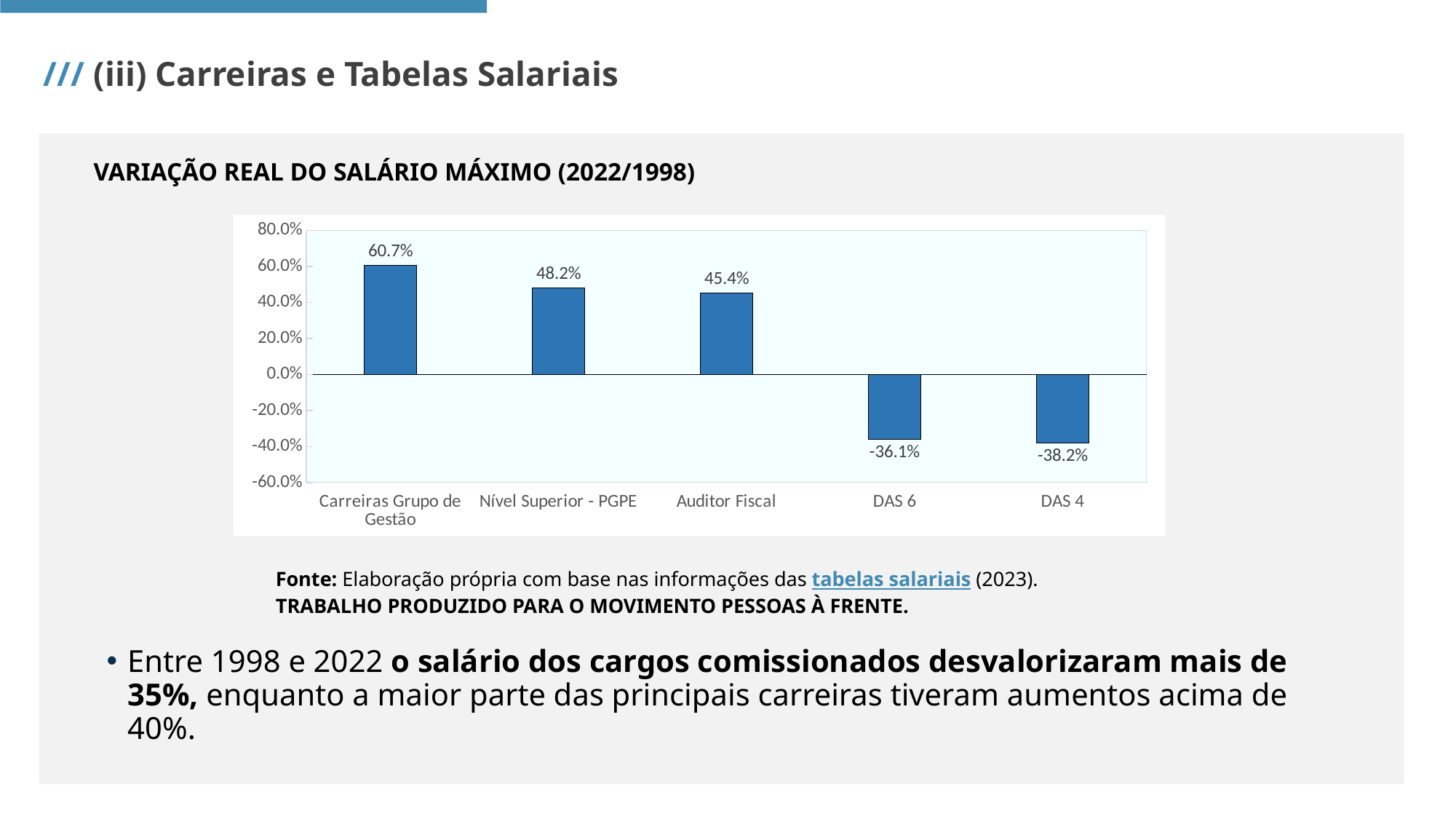
What kind of chart is shown on the slide? Bar chart What is the value for Auditor Fiscal? 45.4% What is the title of the chart? VARIAÇÃO REAL DO SALÁRIO MÁXIMO (2022/1998) Which category has the lowest value? DAS 4 How many categories are shown on the x axis? 5 Which category has the highest value? Carreiras Grupo de Gestão What is the value for Nível Superior - PGPE? 48.2% Which is larger, the value for Nível Superior - PGPE or the value for Auditor Fiscal? Nível Superior - PGPE What is the value for DAS 6? -36.1% What is the value for Carreiras Grupo de Gestão? 60.7% What is the difference between the values for Carreiras Grupo de Gestão and Auditor Fiscal? 15.3% What is the value for DAS 4? -38.2%